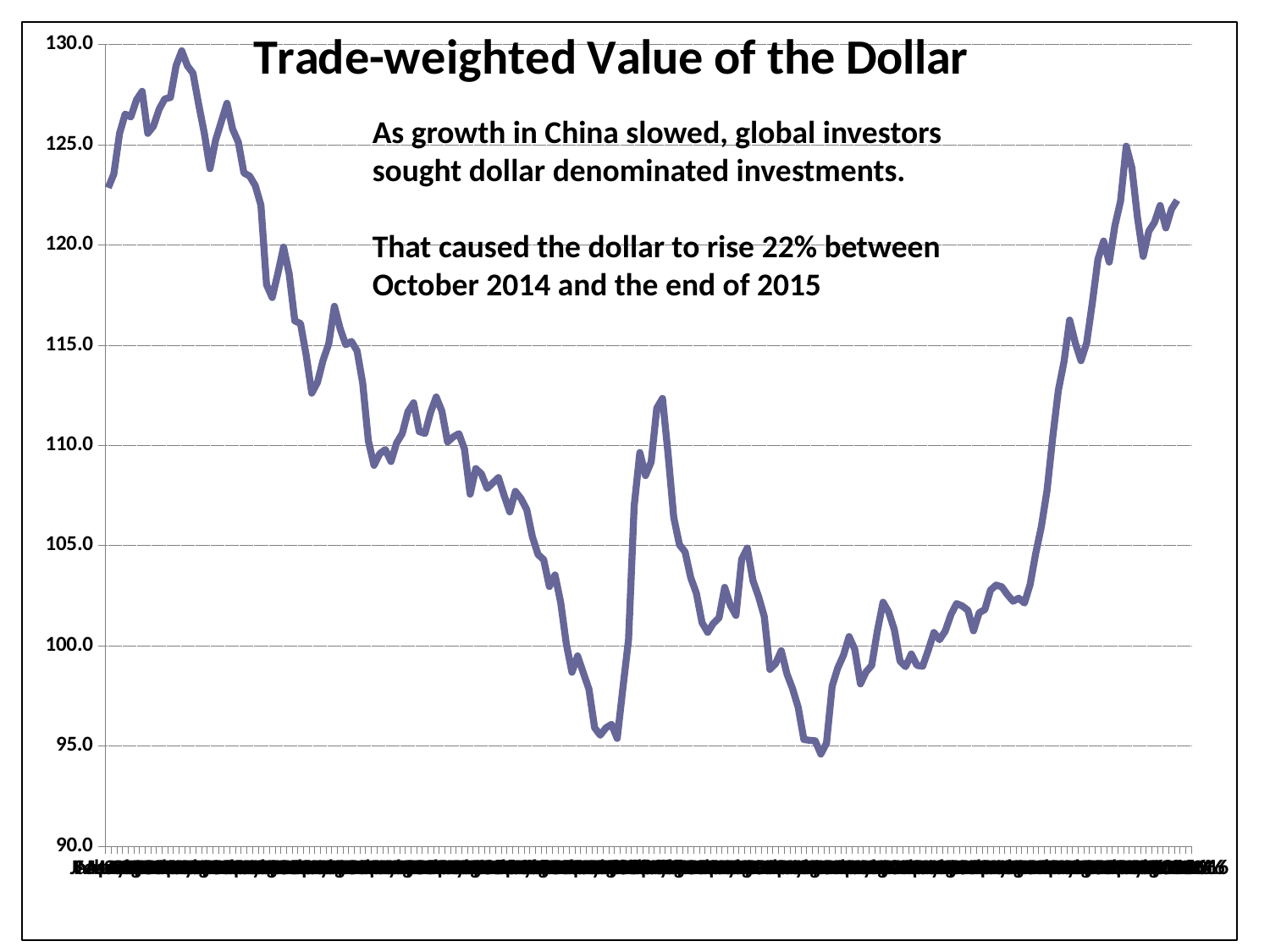
What is the title of the chart? Trade-weighted Value of the Dollar Does the line generally rise or fall over the final portion of the chart? rise What kind of chart is shown on the slide? line chart Is the value at the left-hand start of the line greater or less than 120.0? greater What is the highest value shown on the chart's y axis? 130.0 Does the line generally rise or fall over the first half of the chart? fall Is the highest point reached by the line greater or less than 125.0? greater Is the value at the right-hand end of the line greater or less than 120.0? greater